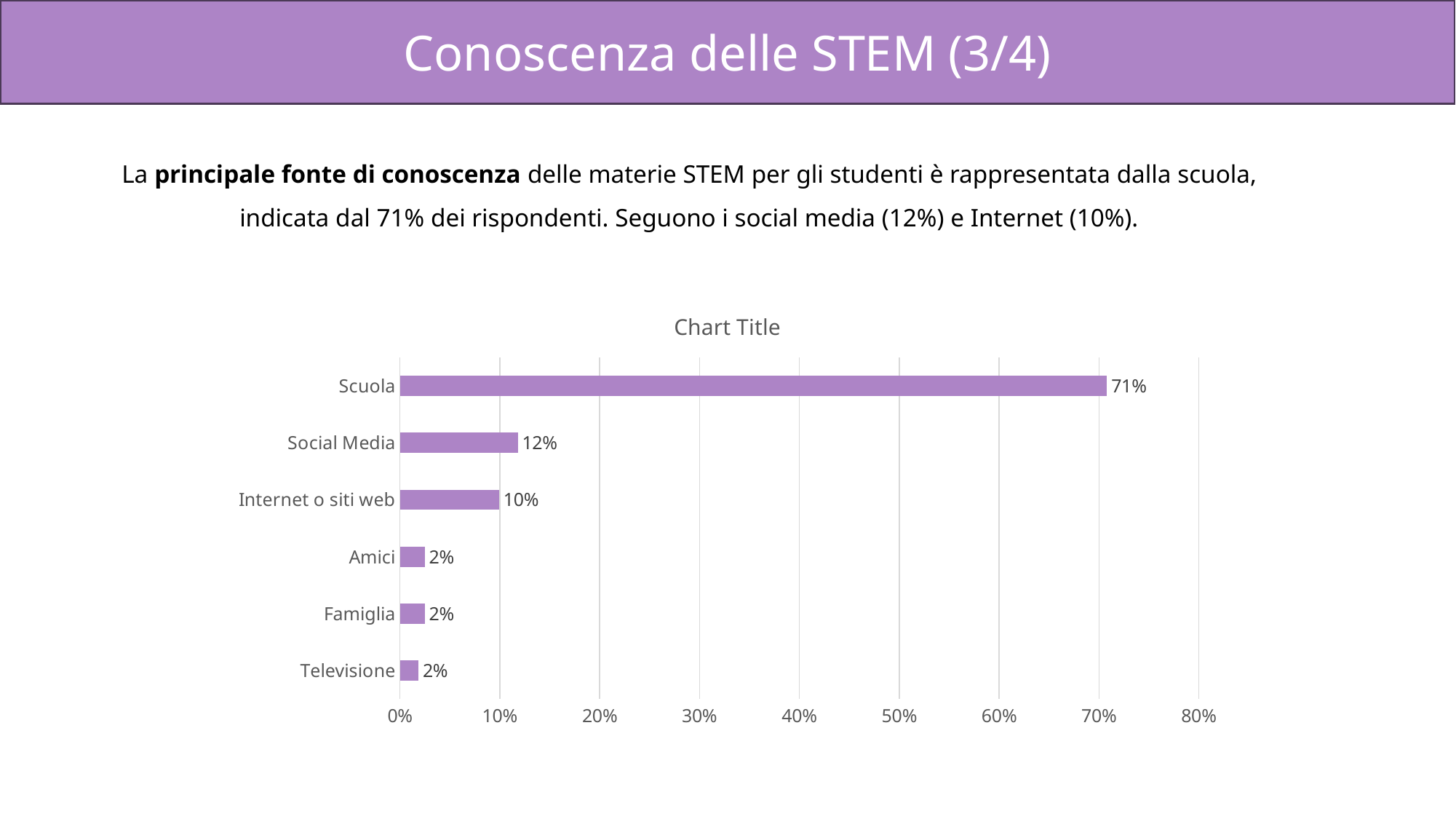
What is the value for Internet o siti web? 10% What is the title shown above the chart? Chart Title What is the difference between the values for Scuola and Social Media? 59% What is the value for Scuola? 71% Is the value for Scuola greater or less than 60%? greater Which category has the highest value? Scuola Which is larger, the value for Social Media or the value for Internet o siti web? Social Media What is the value for Social Media? 12% What is the value for Famiglia? 2% How many categories are shown in the chart? 6 What kind of chart is shown on the slide? bar chart What is the difference between the values for Social Media and Internet o siti web? 2%